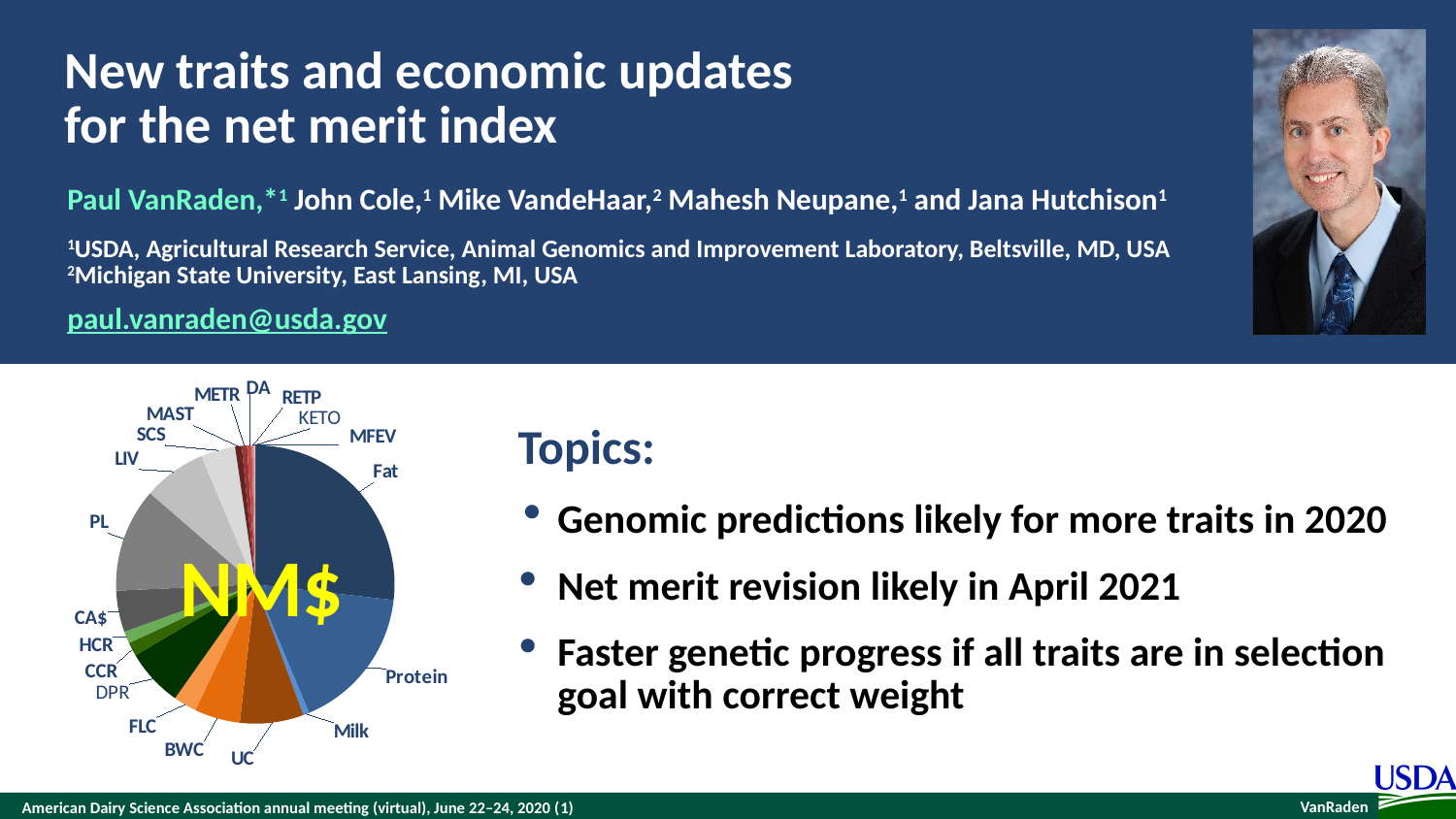
In the NM$ pie chart, which slice is larger, Protein or Milk? Protein In the NM$ pie chart, which slice is larger, Fat or Protein? Fat What text is printed in the center of the pie chart? NM$ In the NM$ pie chart, which slice is larger, Milk or DPR? DPR Which slice of the pie chart is labeled between Fat and Milk? Protein How many slices are labeled in the NM$ pie chart? 19 What kind of chart is shown on the slide? pie chart Which trait has the largest slice in the NM$ pie chart? Fat